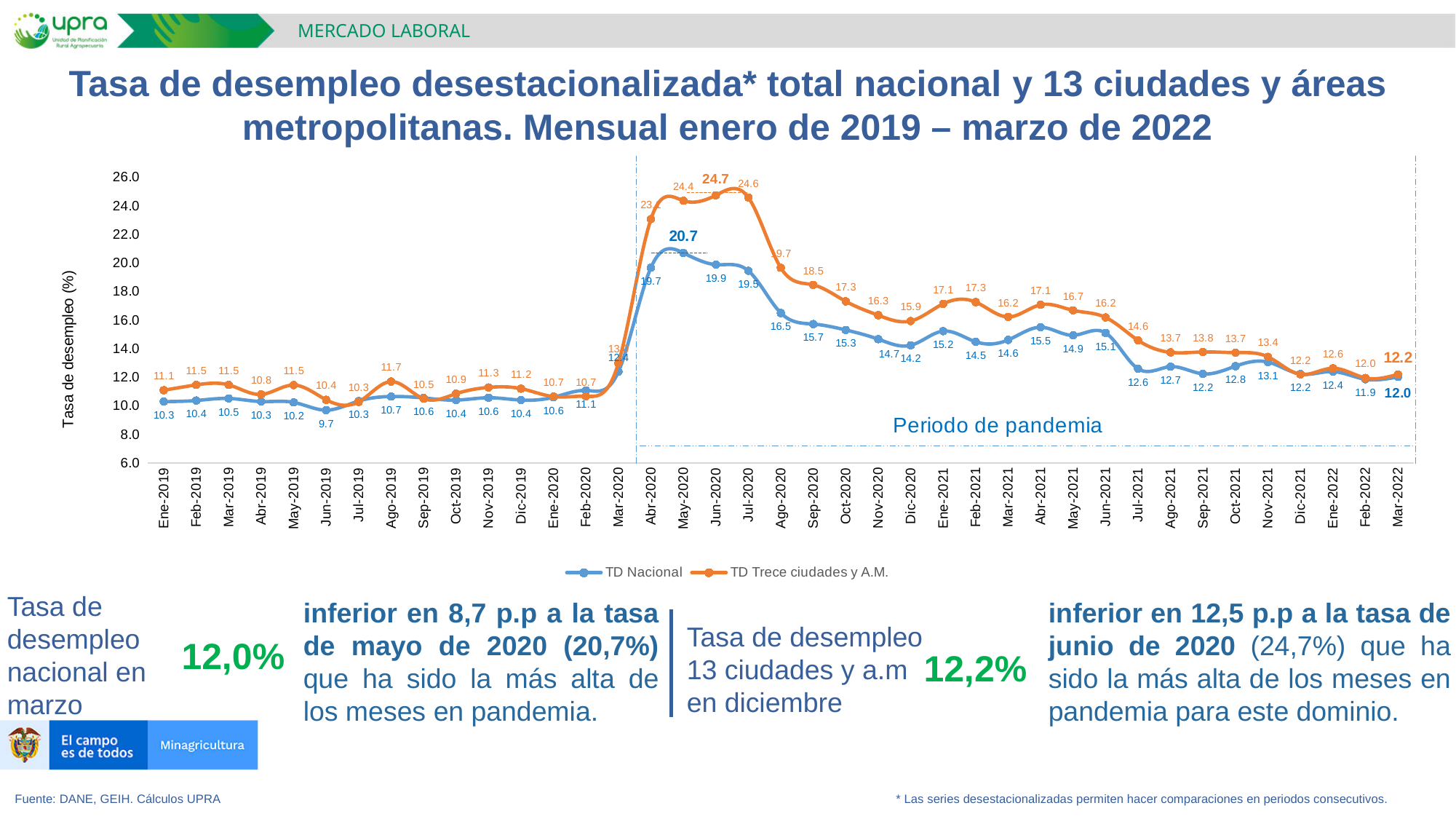
In which month does TD Trece ciudades y A.M. reach its highest value? Jun-2020 What is the value of TD Nacional in Mar-2022? 12.0 What kind of chart is shown on the slide? Line chart What is the difference between the TD Nacional value in May-2020 and in Mar-2022? 8.7 What is the value of TD Nacional in Jun-2019? 9.7 In Ago-2020, which series has the higher value, TD Nacional or TD Trece ciudades y A.M.? TD Trece ciudades y A.M. In which month does TD Nacional reach its highest value? May-2020 How many series does the legend list? 2 Does TD Nacional rise or fall from Jul-2020 to Dic-2020? Fall What is the difference between the TD Trece ciudades y A.M. value in Jun-2020 and in Mar-2022? 12.5 What is the value of TD Trece ciudades y A.M. in Mar-2022? 12.2 In which month is TD Nacional at its lowest value? Jun-2019